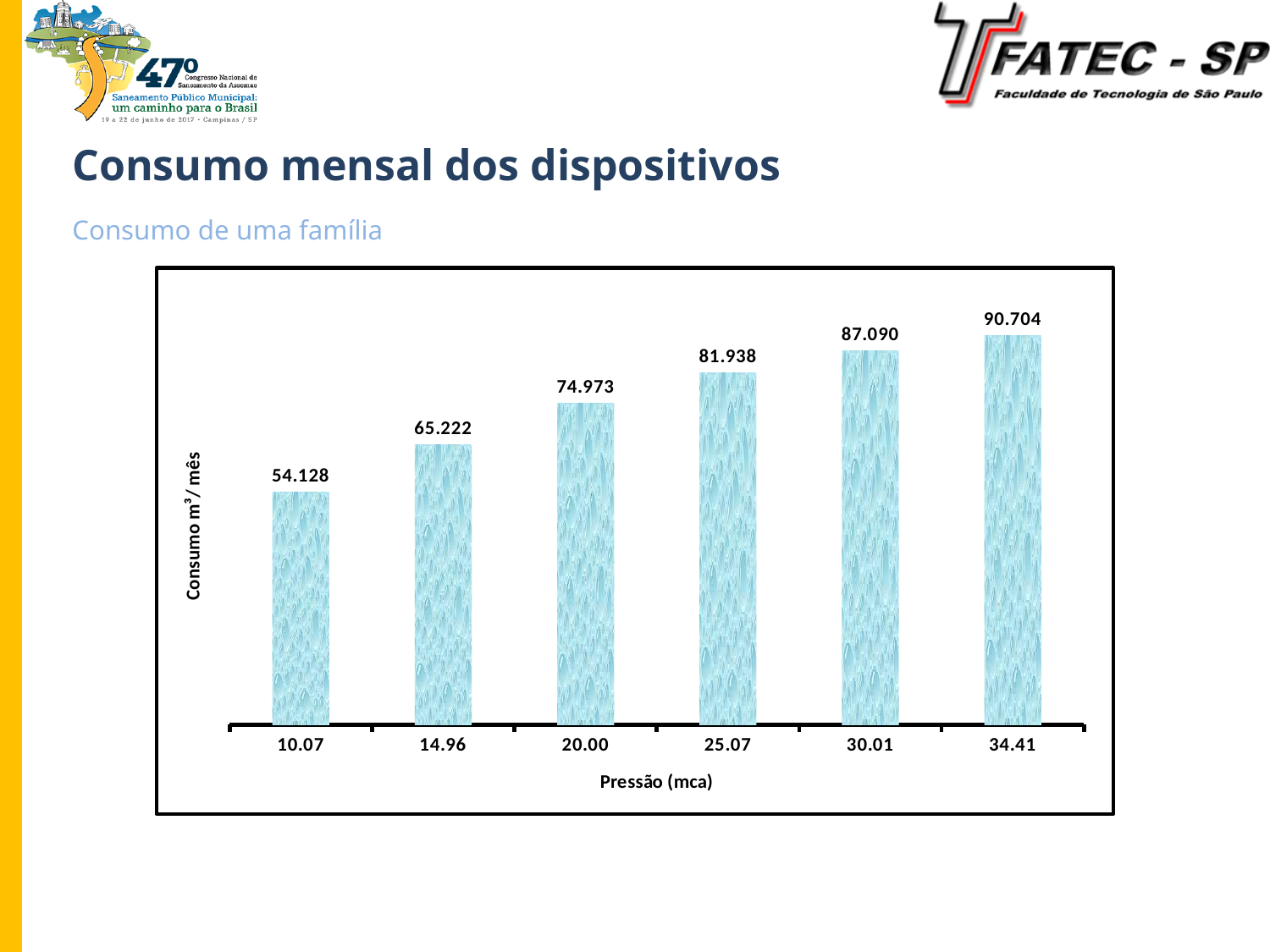
Do the consumption values rise or fall as pressure increases along the x axis? Rise What is the consumption value at a pressure of 10.07 mca? 54.128 What is the difference in consumption between 20.00 mca and 14.96 mca? 9.751 How many pressure values are shown on the x axis? 6 What is the consumption value at a pressure of 30.01 mca? 87.090 Which pressure value has the lowest consumption? 10.07 What is the label of the x axis? Pressão (mca) Which pressure value has the highest consumption? 34.41 What kind of chart is shown on the slide? Bar chart Which has a higher consumption, 14.96 mca or 25.07 mca? 25.07 What is the difference in consumption between 34.41 mca and 10.07 mca? 36.576 What is the consumption value at a pressure of 25.07 mca? 81.938